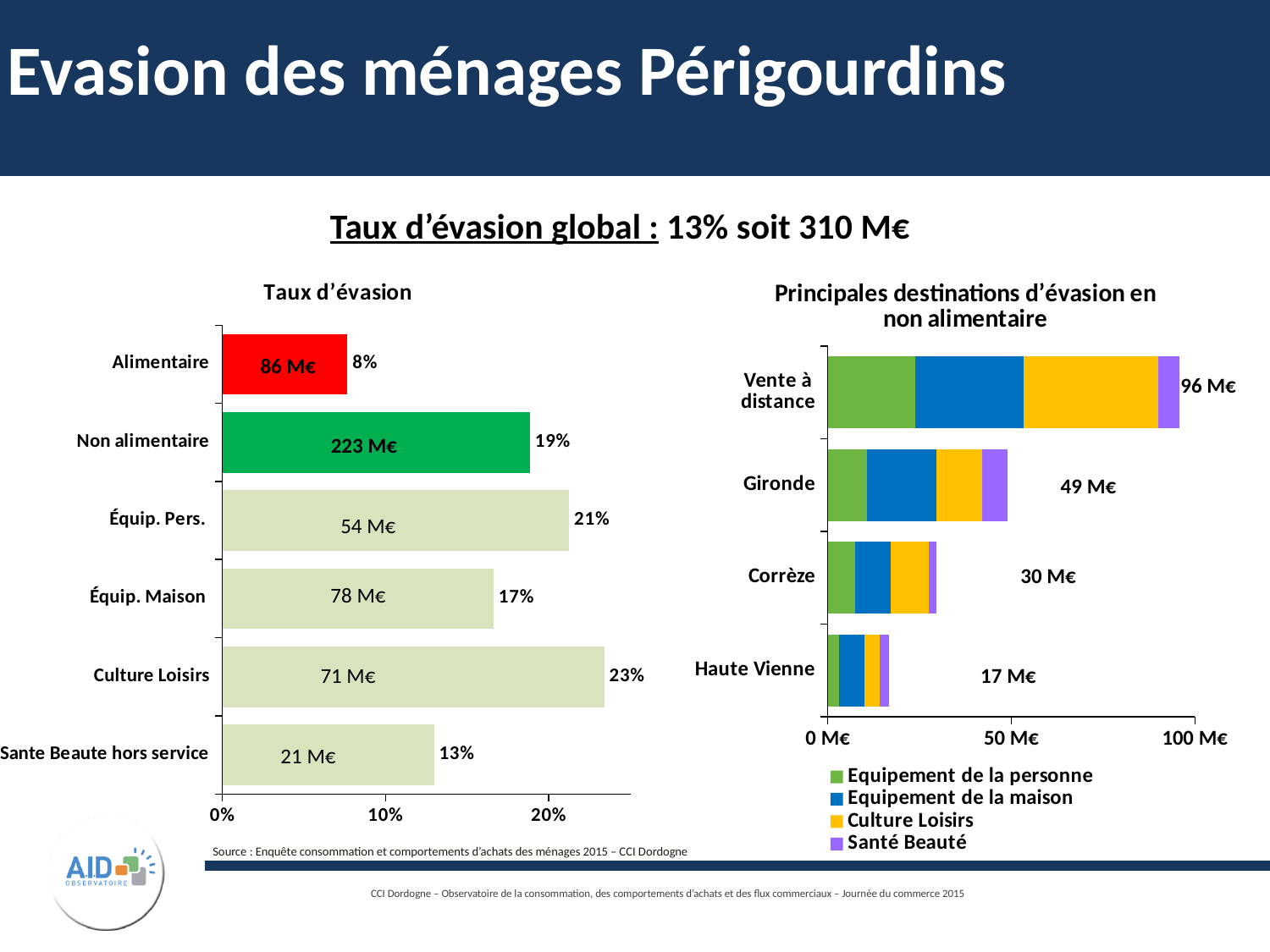
How many series does the legend of the 'Principales destinations d'évasion en non alimentaire' chart list? 4 In the 'Principales destinations d'évasion en non alimentaire' chart, which destination has the highest total? Vente à distance What type of chart is the 'Principales destinations d'évasion en non alimentaire' chart? Stacked bar chart In the 'Taux d'évasion' chart, what amount in M€ is labelled on the Non alimentaire bar? 223 M€ In the 'Taux d'évasion' chart, which category has the lowest rate? Alimentaire In the 'Taux d'évasion' chart, which has the higher rate, Non alimentaire or Sante Beaute hors service? Non alimentaire In the 'Taux d'évasion' chart, what is the difference in percentage points between Équip. Pers. and Équip. Maison? 4 In the 'Principales destinations d'évasion en non alimentaire' chart, what is the total for Gironde? 49 M€ In the 'Taux d'évasion' chart, which category has the highest rate? Culture Loisirs How many categories are shown in the 'Taux d'évasion' chart? 6 In the 'Taux d'évasion' chart, what is the rate shown for Culture Loisirs? 23% In the 'Principales destinations d'évasion en non alimentaire' chart, what is the difference between the totals for Vente à distance and Haute Vienne? 79 M€